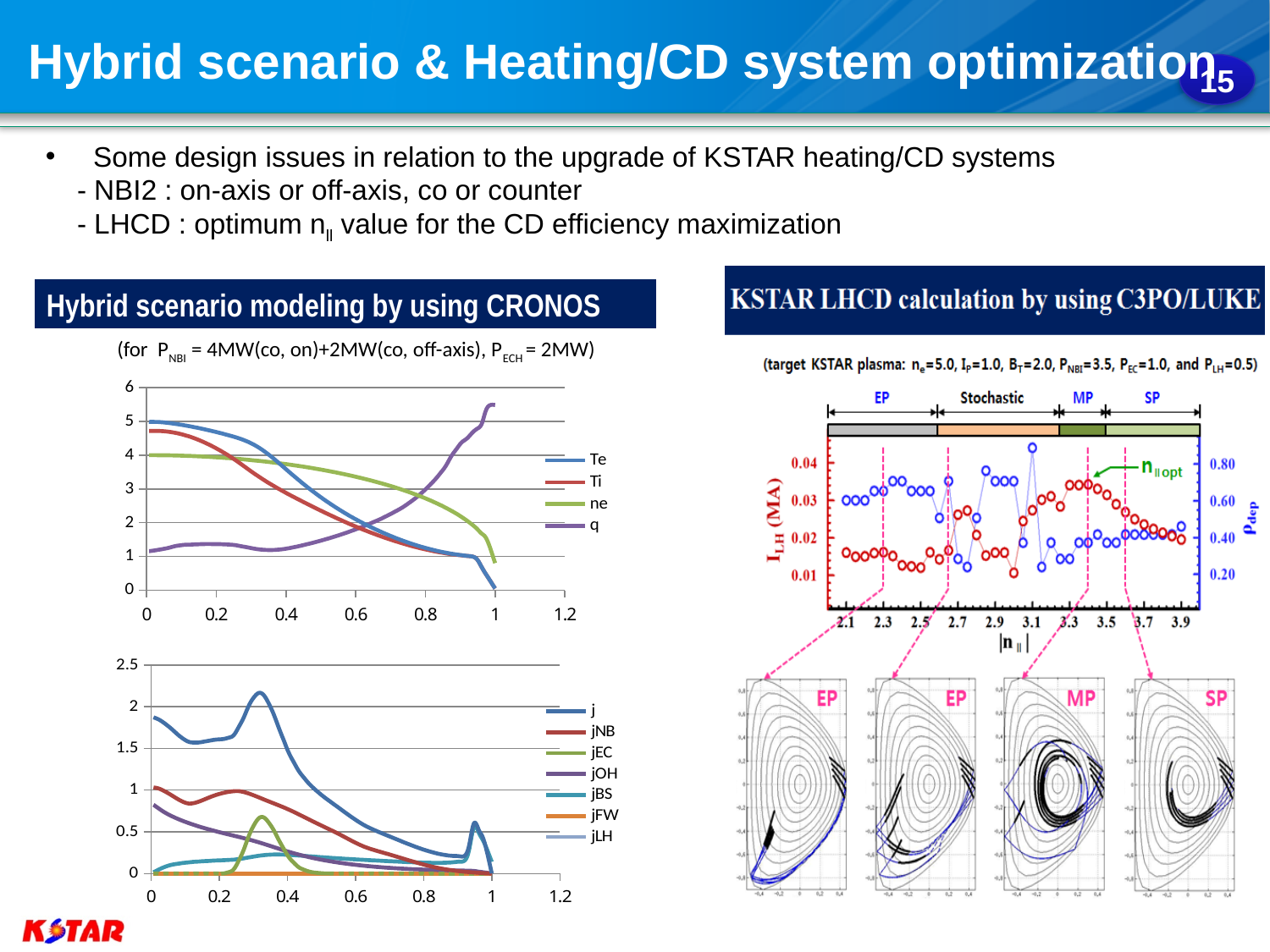
In the top-left chart, does the Te series rise or fall as x increases from 0 to 1? falls What kind of chart is the top chart on the left side of the slide (with series Te, Ti, ne, q)? line chart In the top-left chart, is the value of Te at x = 0 greater or less than 4? greater How many series does the legend of the bottom-left chart (with series j, jNB, jEC, ...) list? 7 In the top-left chart, which series has the larger value at x = 0, Te or q? Te In the top-left chart, is the value of q at x = 0 greater or less than 2? less In the top-left chart, is the value of ne at x = 0 greater or less than 3? greater In the top-left chart, does the q series rise or fall as x increases from 0 to 1? rises How many series does the legend of the top-left chart list? 4 In the bottom-left chart, which series reaches the highest value? j What is the title of the chart on the right side of the slide? KSTAR LHCD calculation by using C3PO/LUKE